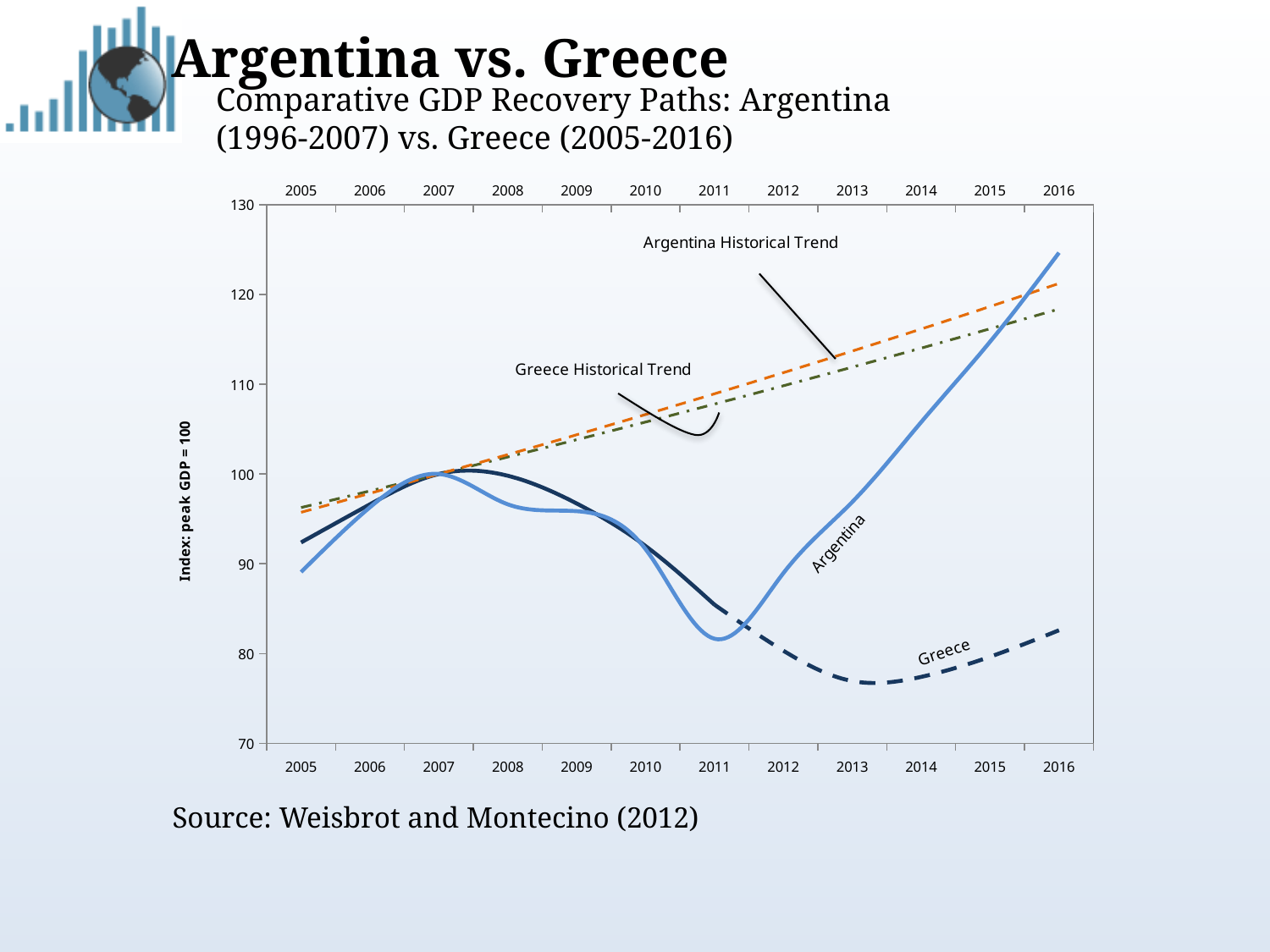
What is the label on the y axis of the chart? Index: peak GDP = 100 Is the value for Greece in 2013 greater or less than 80? less In 2016, which line is higher, Argentina or Greece? Argentina Does the Argentina line rise or fall between 2011 and 2016? rise Is the value for Greece in 2016 greater or less than 90? less What kind of chart is shown on the slide? line chart How many years are marked along the x axis of the chart? 12 In 2013, which line is higher, Argentina or Greece? Argentina Is the value for Argentina in 2016 greater or less than 120? greater Does the Greece line rise or fall between 2007 and 2013? fall